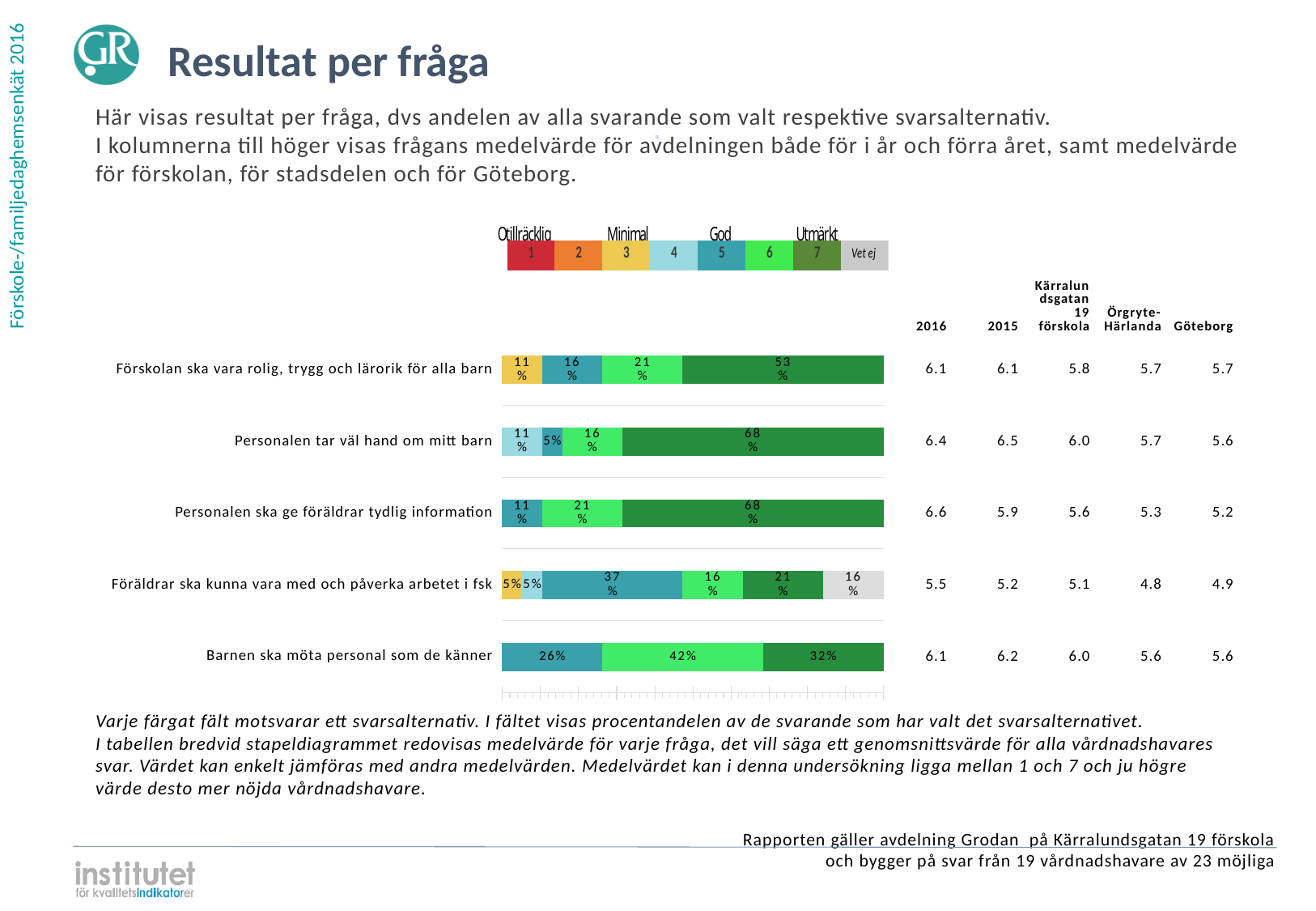
What percentage answered "Vet ej" for "Föräldrar ska kunna vara med och påverka arbetet i fsk"? 16% What is the 2016 mean value shown for "Personalen ska ge föräldrar tydlig information"? 6.6 What percentage chose 5 (God) for "Föräldrar ska kunna vara med och påverka arbetet i fsk"? 37% What percentage of respondents chose 7 (Utmärkt) for "Förskolan ska vara rolig, trygg och lärorik för alla barn"? 53% Which is larger for "Barnen ska möta personal som de känner": the share choosing 5 or the share choosing 7? 7 (32%) How many answer alternatives does the legend above the chart list? 8 What type of chart is shown on the slide? Stacked bar chart Which question has the lowest share of respondents choosing 7 (Utmärkt)? Föräldrar ska kunna vara med och påverka arbetet i fsk How many questions (categories) are plotted in the bar chart? 5 What percentage chose 7 for "Personalen tar väl hand om mitt barn"? 68% What is the difference between the share choosing 7 and the share choosing 6 for "Personalen ska ge föräldrar tydlig information"? 47% What percentage chose 6 for "Barnen ska möta personal som de känner"? 42%